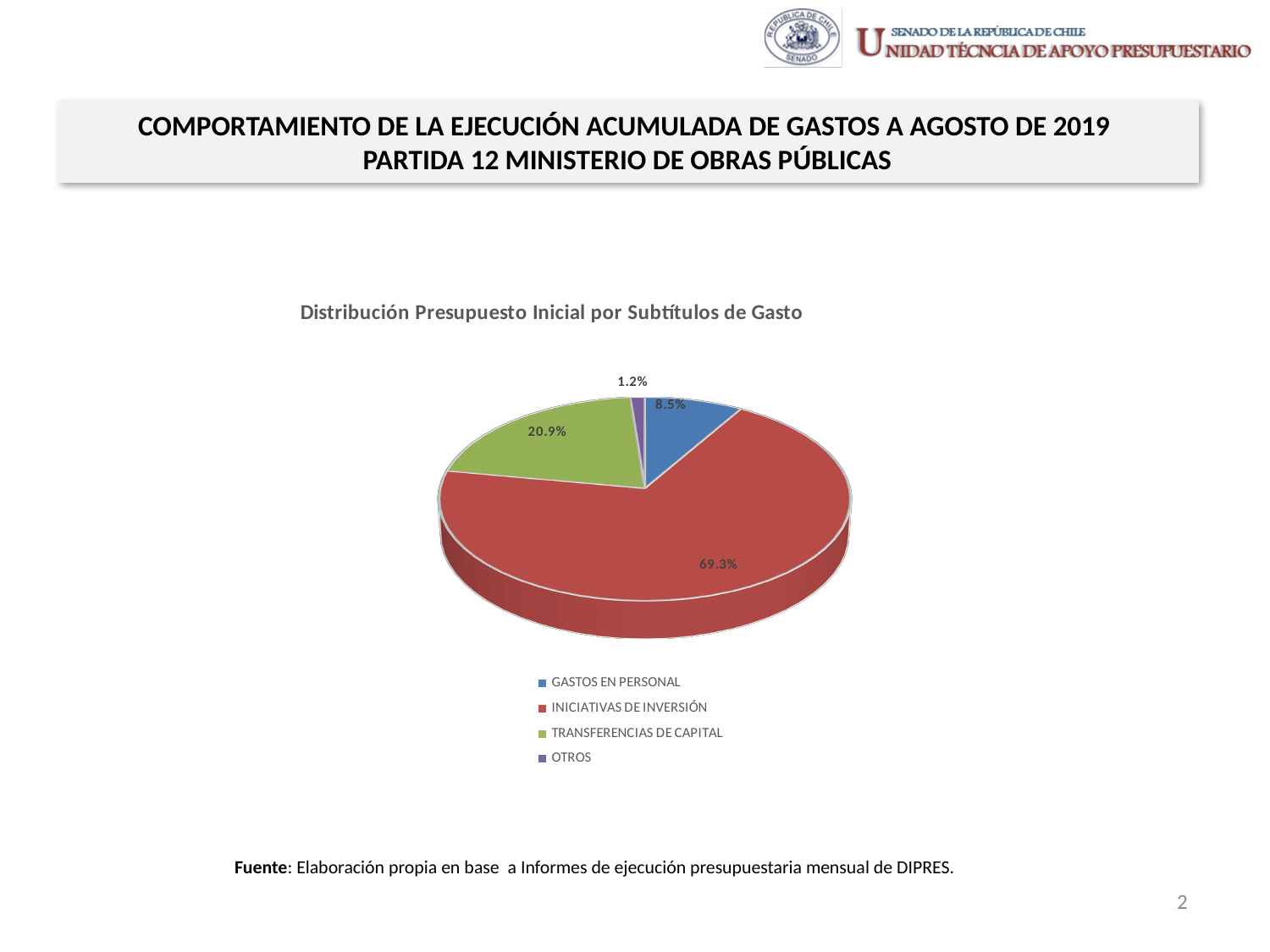
What share of the pie does TRANSFERENCIAS DE CAPITAL represent? 20.9% What is the difference in percentage points between INICIATIVAS DE INVERSIÓN and TRANSFERENCIAS DE CAPITAL? 48.4 Which category has the largest slice of the pie? INICIATIVAS DE INVERSIÓN How many categories does the legend list? 4 What colour is the slice for INICIATIVAS DE INVERSIÓN? Red Which is larger, the share for GASTOS EN PERSONAL or the share for TRANSFERENCIAS DE CAPITAL? TRANSFERENCIAS DE CAPITAL What share of the pie does OTROS represent? 1.2% What type of chart is shown on the slide? Pie chart What share of the pie does INICIATIVAS DE INVERSIÓN represent? 69.3% Which category has the smallest slice of the pie? OTROS What is the title of the chart? Distribución Presupuesto Inicial por Subtítulos de Gasto